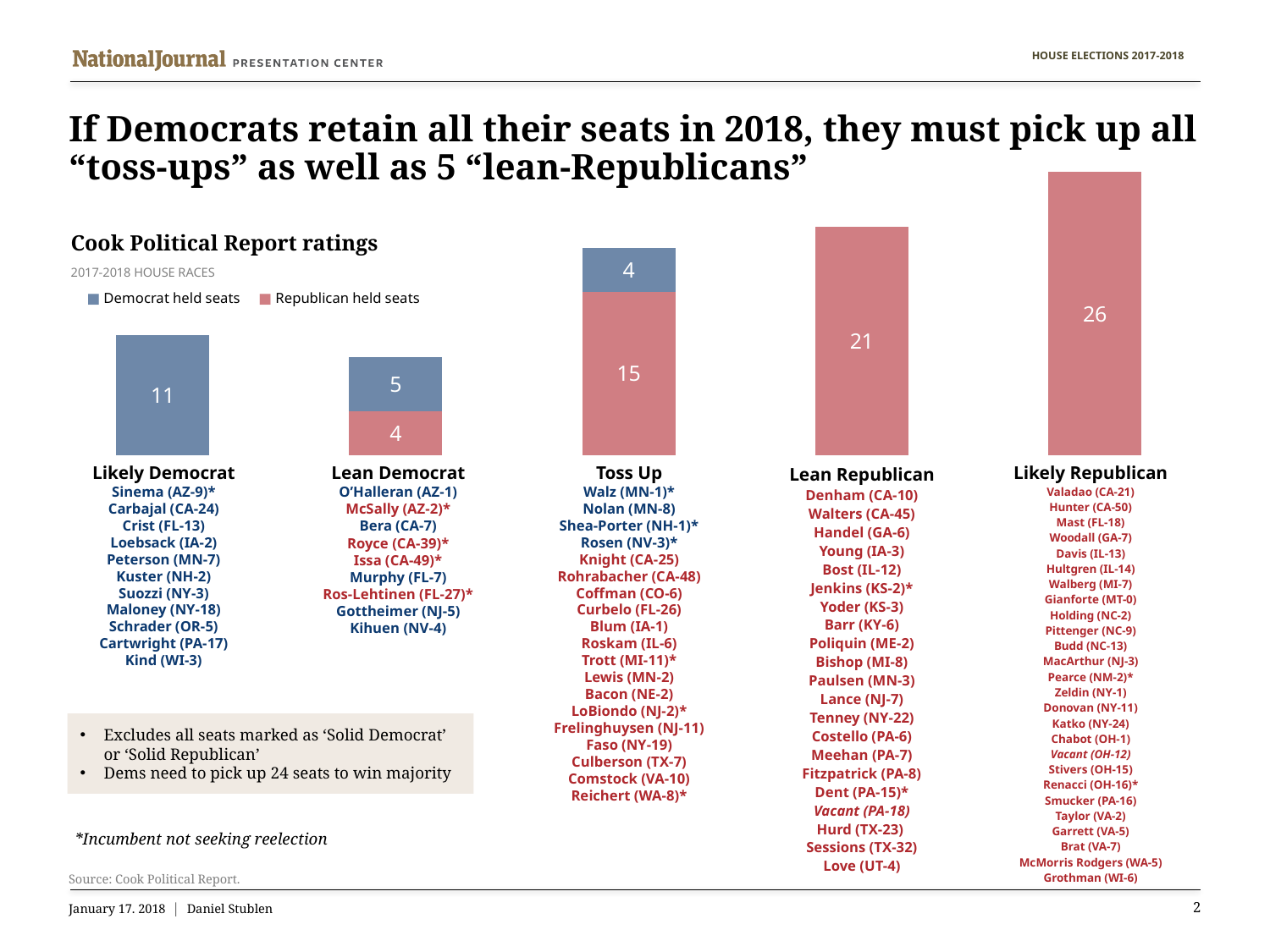
How many Republican held seats are in the "Toss Up" category? 15 What kind of chart is shown under the title "Cook Political Report ratings"? Stacked bar chart How many series does the legend list in the "Cook Political Report ratings" chart? 2 How many Republican held seats are in the "Likely Republican" category? 26 Which category has the tallest bar in the "Cook Political Report ratings" chart? Likely Republican What is the total number of seats in the "Lean Democrat" bar? 9 How many Democrat held seats are in the "Likely Democrat" category? 11 How many categories are shown along the x axis of the "Cook Political Report ratings" chart? 5 How many Democrat held seats are in the "Lean Democrat" category? 5 Which colour represents Republican held seats in the legend? Red What is the difference between the Republican held seats in "Likely Republican" and in "Lean Republican"? 5 What is the total number of seats in the "Toss Up" bar? 19